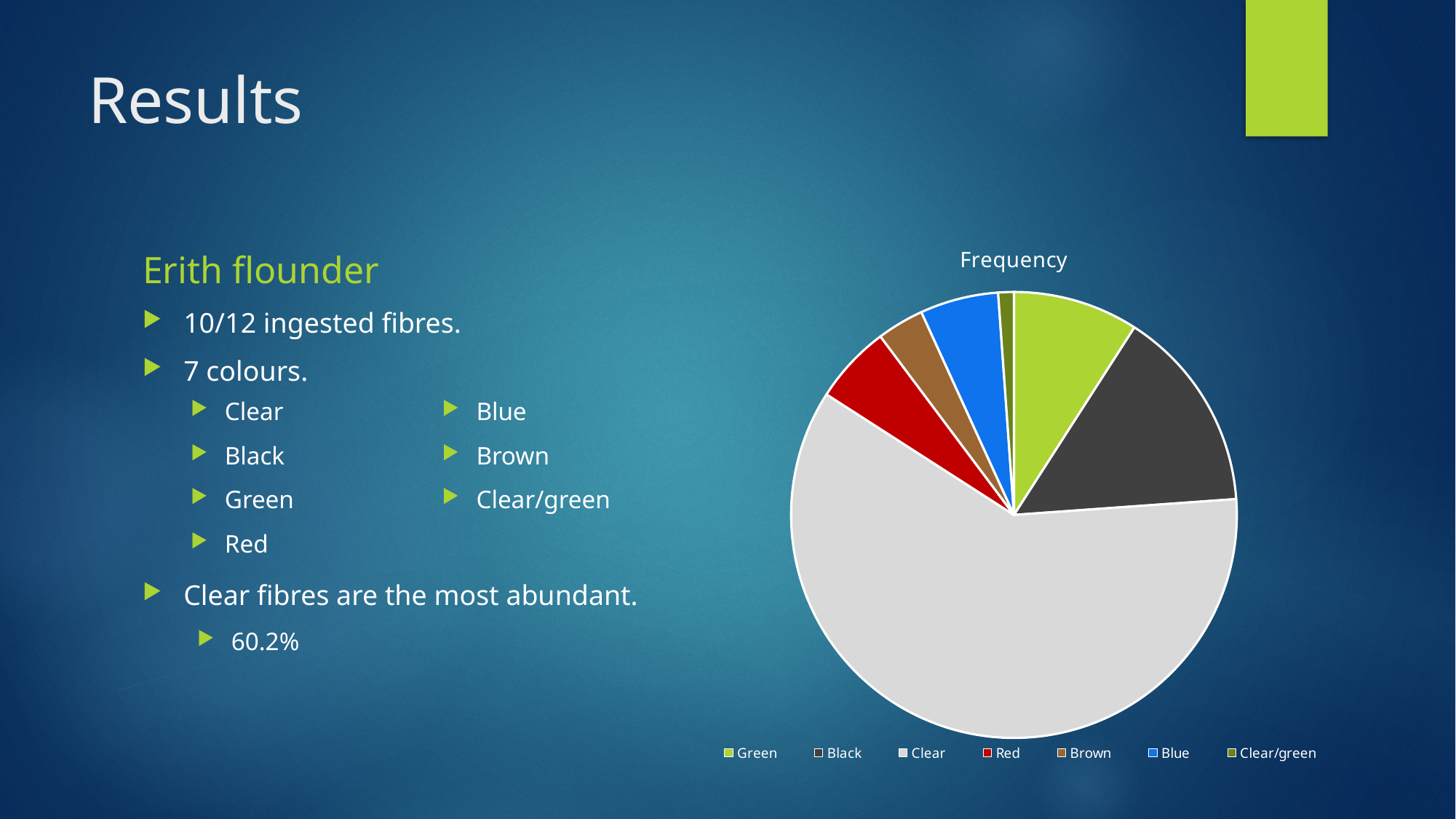
Which slice is larger, Red or Brown? Red Which slice is larger, Green or Red? Green What kind of chart is shown on the slide? pie chart Which slice is larger, Black or Green? Black What is the title of the pie chart? Frequency What colour is the Clear slice in the pie chart? light grey Which category has the smallest slice of the pie chart? Clear/green What share of the pie does the Clear slice take, according to the slide? 60.2% Which category has the largest slice of the pie chart? Clear How many categories does the pie chart show? 7